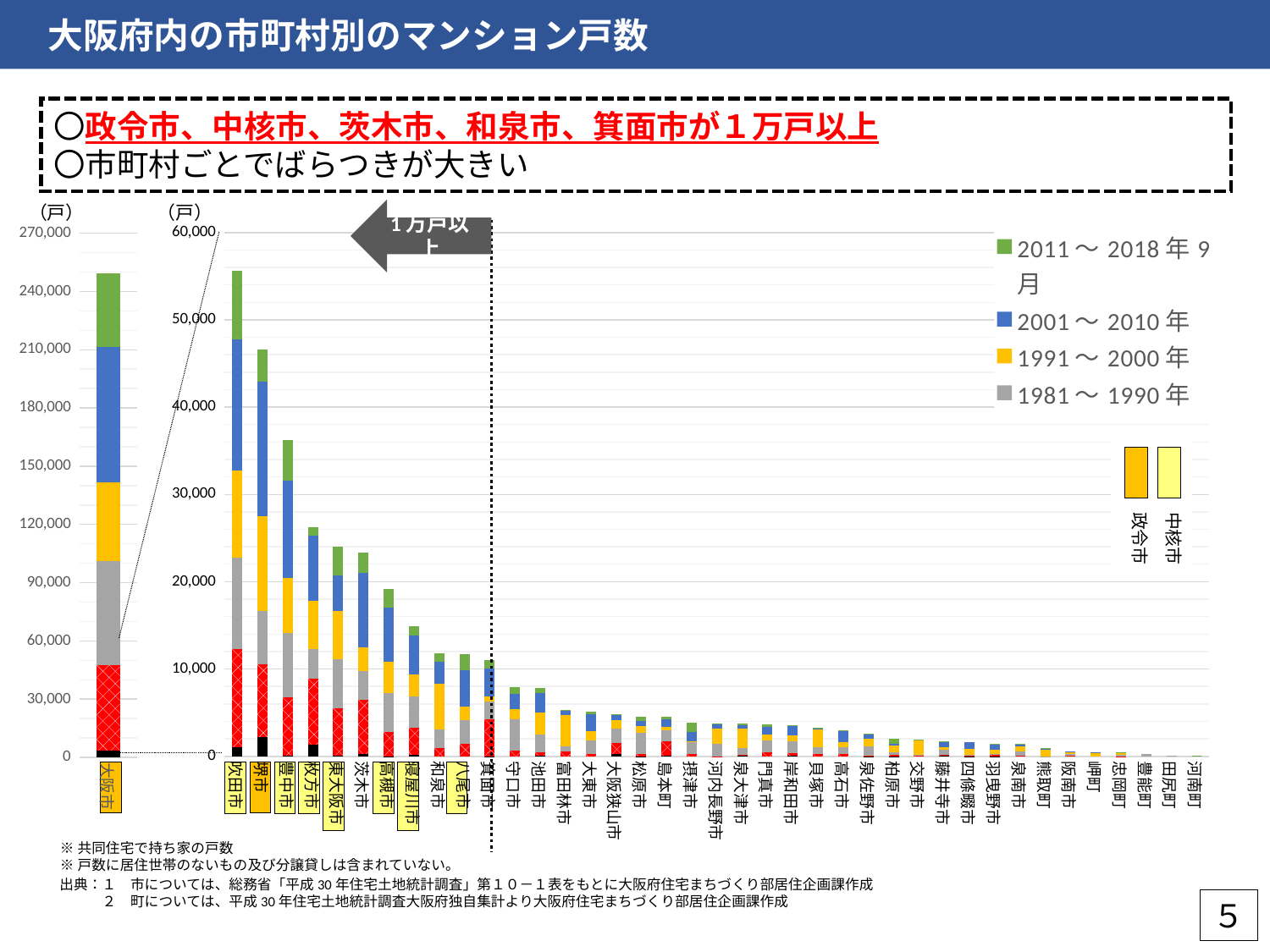
Which municipality is shown in the left-hand chart? 大阪市 In the right-hand chart, do the totals rise or fall from left to right along the x axis? fall In the right-hand chart, which is larger, the total for 吹田市 or for 堺市? 吹田市 In the right-hand chart, which municipality has the lowest total? 河南町 In the right-hand chart, which is larger, the total for 高槻市 or for 寝屋川市? 高槻市 In the right-hand chart, is the total for 茨木市 greater or less than 30,000? less In the right-hand chart, is the total for 守口市 greater or less than 10,000? less In the right-hand chart, which municipality has the highest total? 吹田市 How many series does the legend list? 4 In the right-hand chart, is the total for 吹田市 greater or less than 50,000? greater What kind of chart is used on this slide? Stacked bar chart